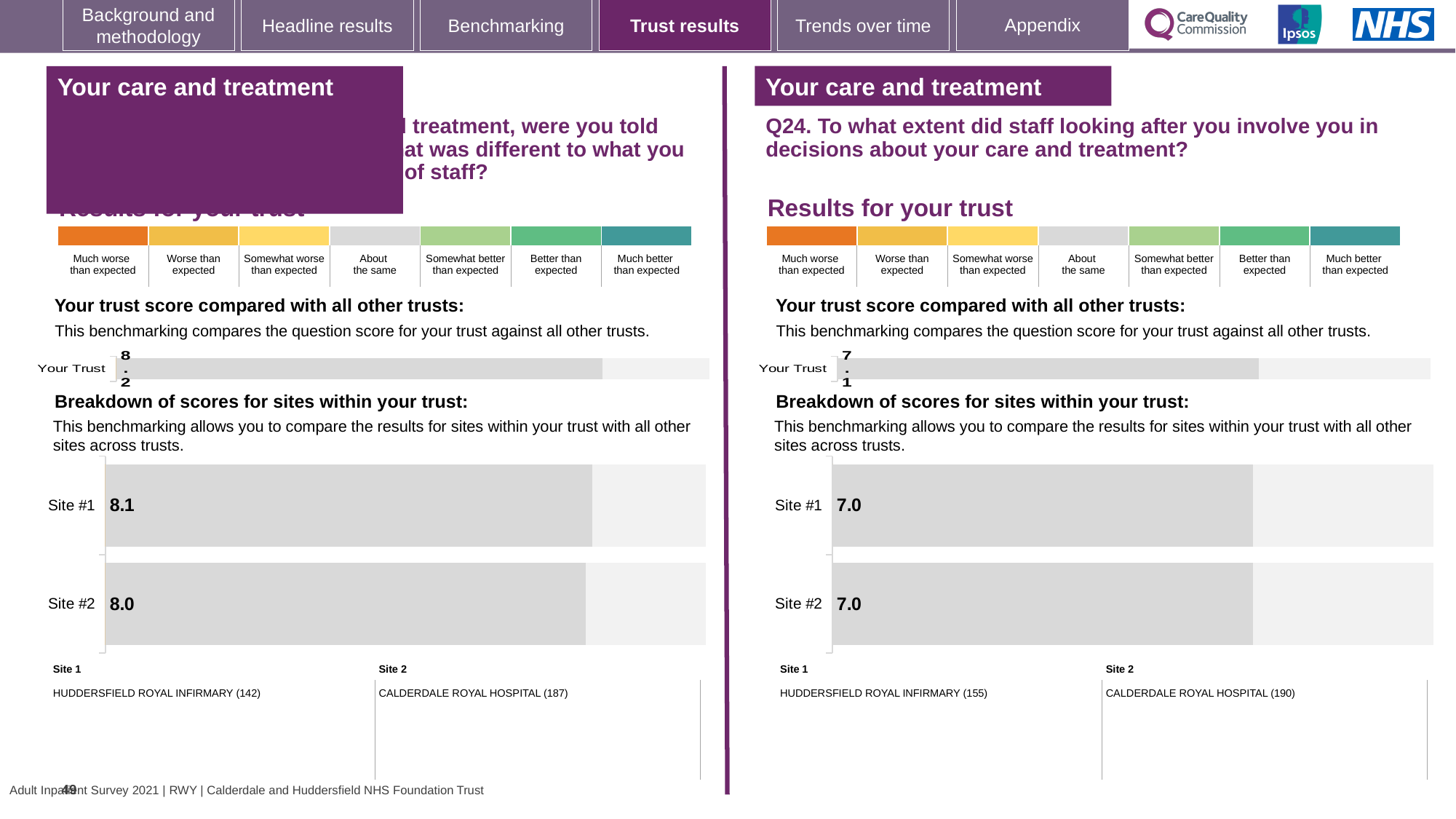
What type of chart is used for the site breakdown on the left-hand side of the slide? Bar chart How many sites are shown on the Q24 site breakdown chart on the right? 2 On the left-hand site breakdown chart, what is the score for Site #2? 8.0 On the left-hand site breakdown chart, what is the score for Site #1? 8.1 Is the Site #1 score on the left-hand chart larger or smaller than the Site #1 score on the Q24 chart on the right? Larger On the Q24 'Your Trust' bar on the right, what is the trust score shown? 7.1 On the Q24 site breakdown chart on the right, what is the difference between the Site #1 and Site #2 scores? 0.0 On the left-hand 'Your Trust' bar, what is the trust score shown? 8.2 On the left-hand site breakdown chart, which site has the higher score? Site #1 On the Q24 site breakdown chart on the right, what is the score for Site #1? 7.0 On the Q24 site breakdown chart on the right, what is the score for Site #2? 7.0 On the left-hand site breakdown chart, what is the difference between the Site #1 and Site #2 scores? 0.1